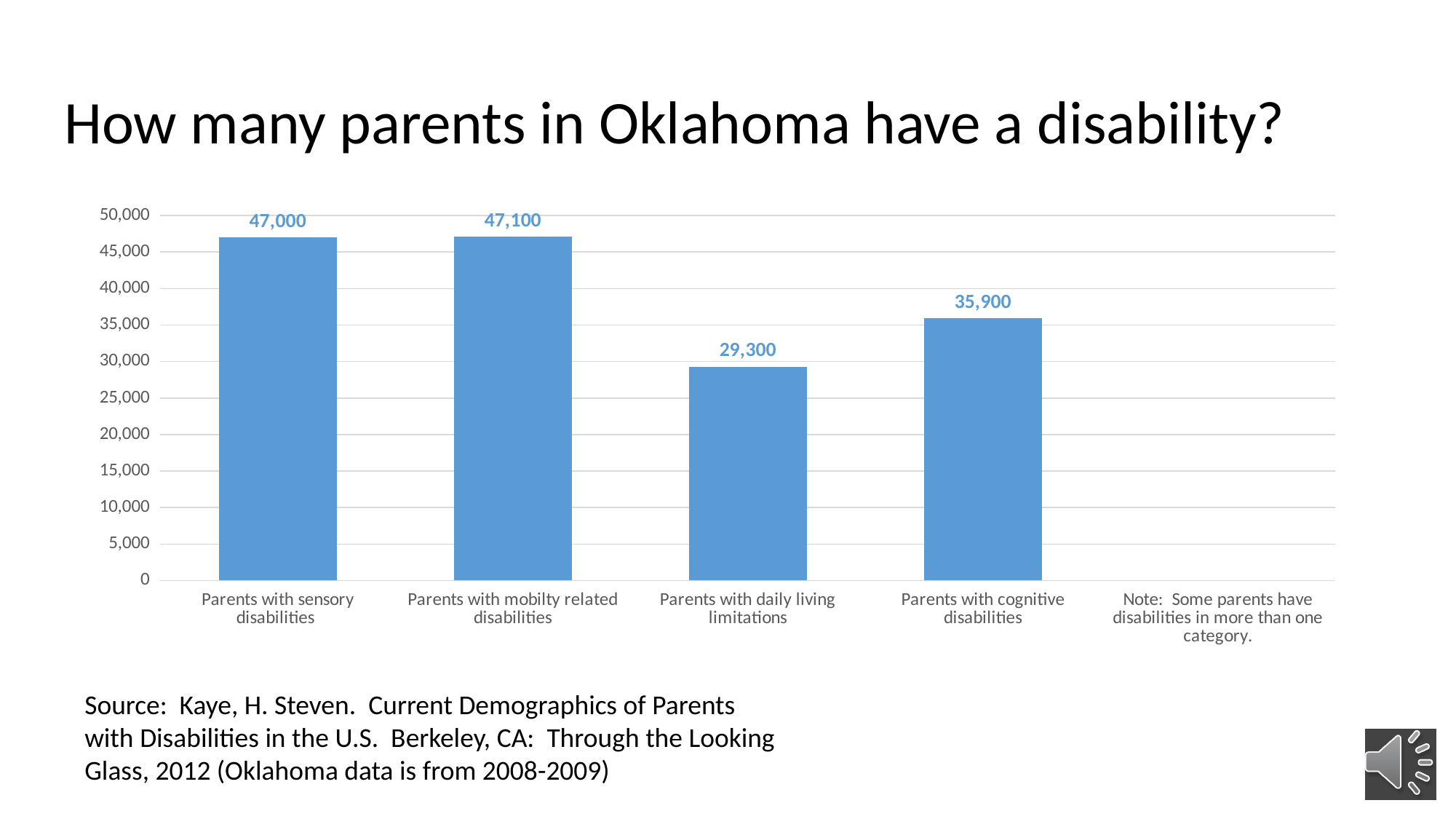
What is the difference between the values for Parents with cognitive disabilities and Parents with daily living limitations? 6,600 What is the value for Parents with daily living limitations? 29,300 How many bars are plotted in the chart? 4 What is the difference between the values for Parents with mobilty related disabilities and Parents with daily living limitations? 17,800 Which is larger, the value for Parents with cognitive disabilities or the value for Parents with daily living limitations? Parents with cognitive disabilities Which category has the lowest value? Parents with daily living limitations What is the value for Parents with cognitive disabilities? 35,900 What is the value for Parents with sensory disabilities? 47,000 Which category has the highest value according to the data labels? Parents with mobilty related disabilities What kind of chart is shown on the slide? bar chart What is the value for Parents with mobilty related disabilities? 47,100 Is the value for Parents with cognitive disabilities greater or less than 30,000? greater